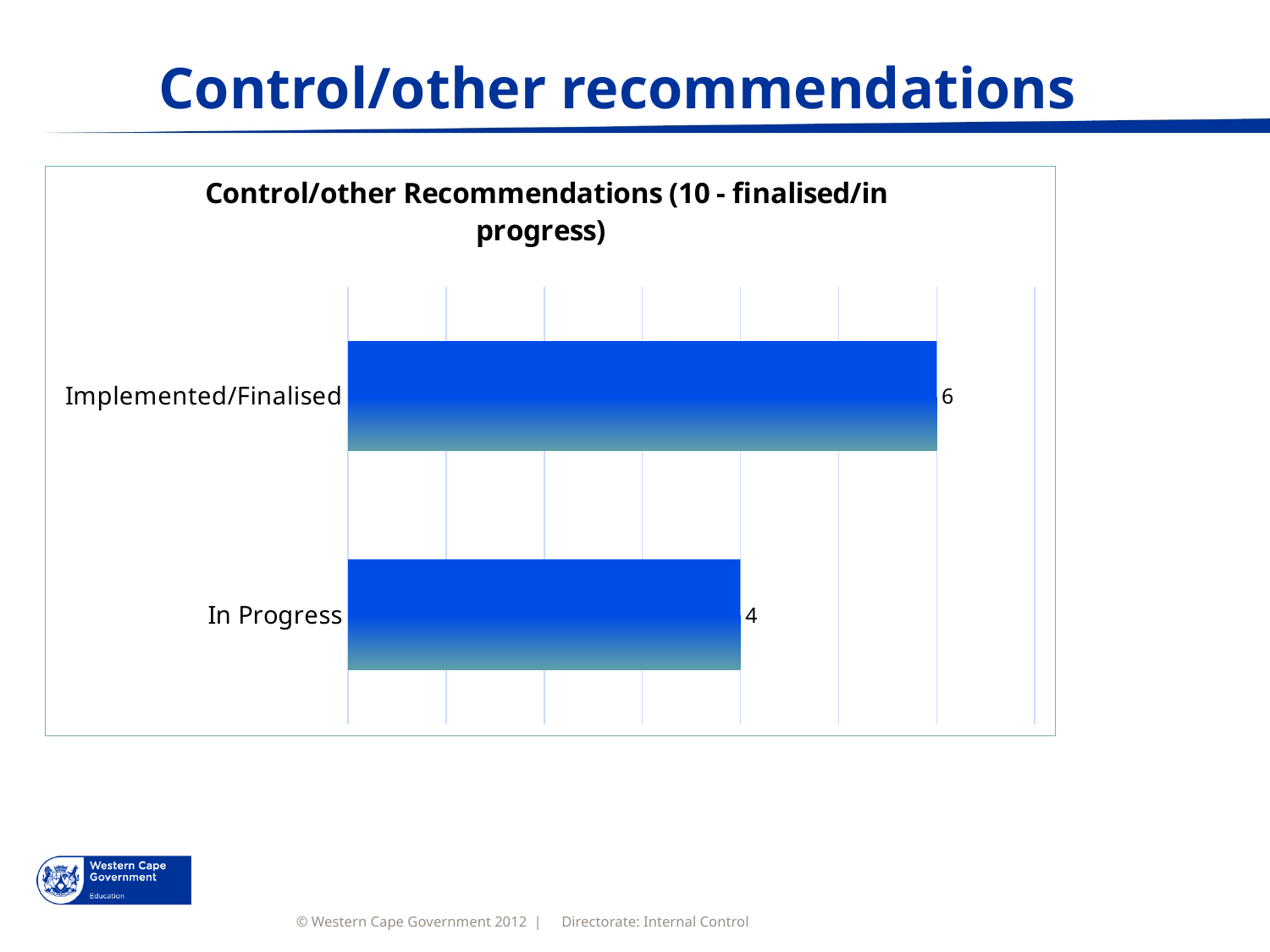
What kind of chart is shown on the slide? Bar chart Which category has the highest value? Implemented/Finalised What is the total of the values for Implemented/Finalised and In Progress? 10 What is the title of the chart? Control/other Recommendations (10 - finalised/in progress) What is the value for In Progress? 4 How many categories are shown in the chart? 2 Are the bars in the chart horizontal or vertical? Horizontal What is the difference between the values for Implemented/Finalised and In Progress? 2 What is the value for Implemented/Finalised? 6 Which category has the lowest value? In Progress Which is larger, the value for Implemented/Finalised or the value for In Progress? Implemented/Finalised